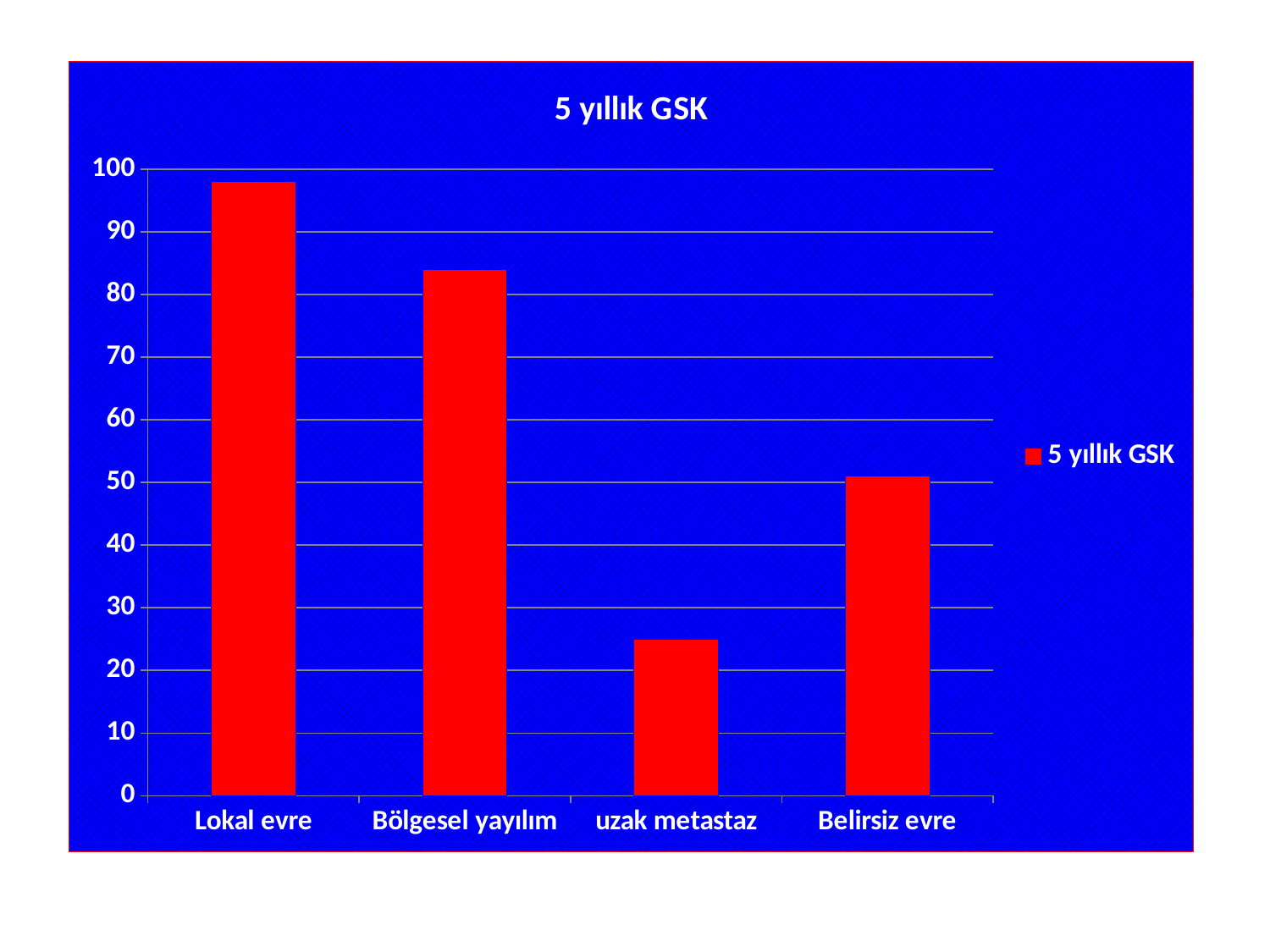
Is the value for uzak metastaz greater or less than 30? less Which category has the highest value? Lokal evre Is the value for Bölgesel yayılım greater or less than 80? greater Which category has the lowest value? uzak metastaz How many categories are shown on the x axis? 4 What type of chart is shown on the slide? bar chart Which is larger, the value for Bölgesel yayılım or the value for Belirsiz evre? Bölgesel yayılım What colour are the bars in the chart? red Is the value for Lokal evre greater or less than 90? greater What is the title of the chart? 5 yıllık GSK How many series does the legend list? 1